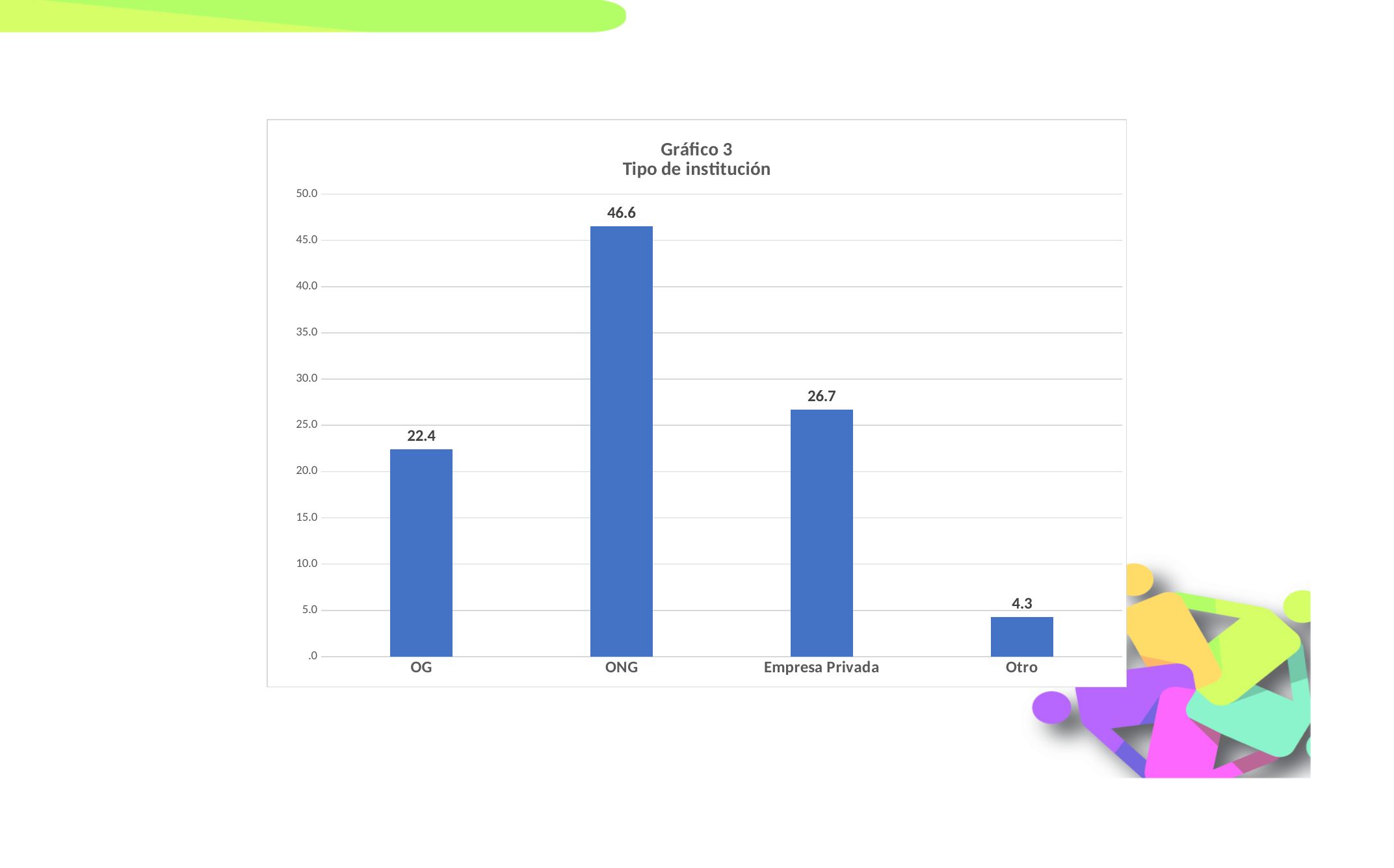
What is the value for Otro? 4.3 What kind of chart is shown on the slide? bar chart Which category has the lowest value? Otro What is the value for ONG? 46.6 How many categories are shown on the x axis? 4 What is the difference between the values for ONG and Empresa Privada? 19.9 What is the value for Empresa Privada? 26.7 What is the value for OG? 22.4 Which category has the highest value? ONG Which is larger, the value for OG or the value for Empresa Privada? Empresa Privada What is the title of the chart? Gráfico 3 Tipo de institución What is the difference between the values for OG and Otro? 18.1